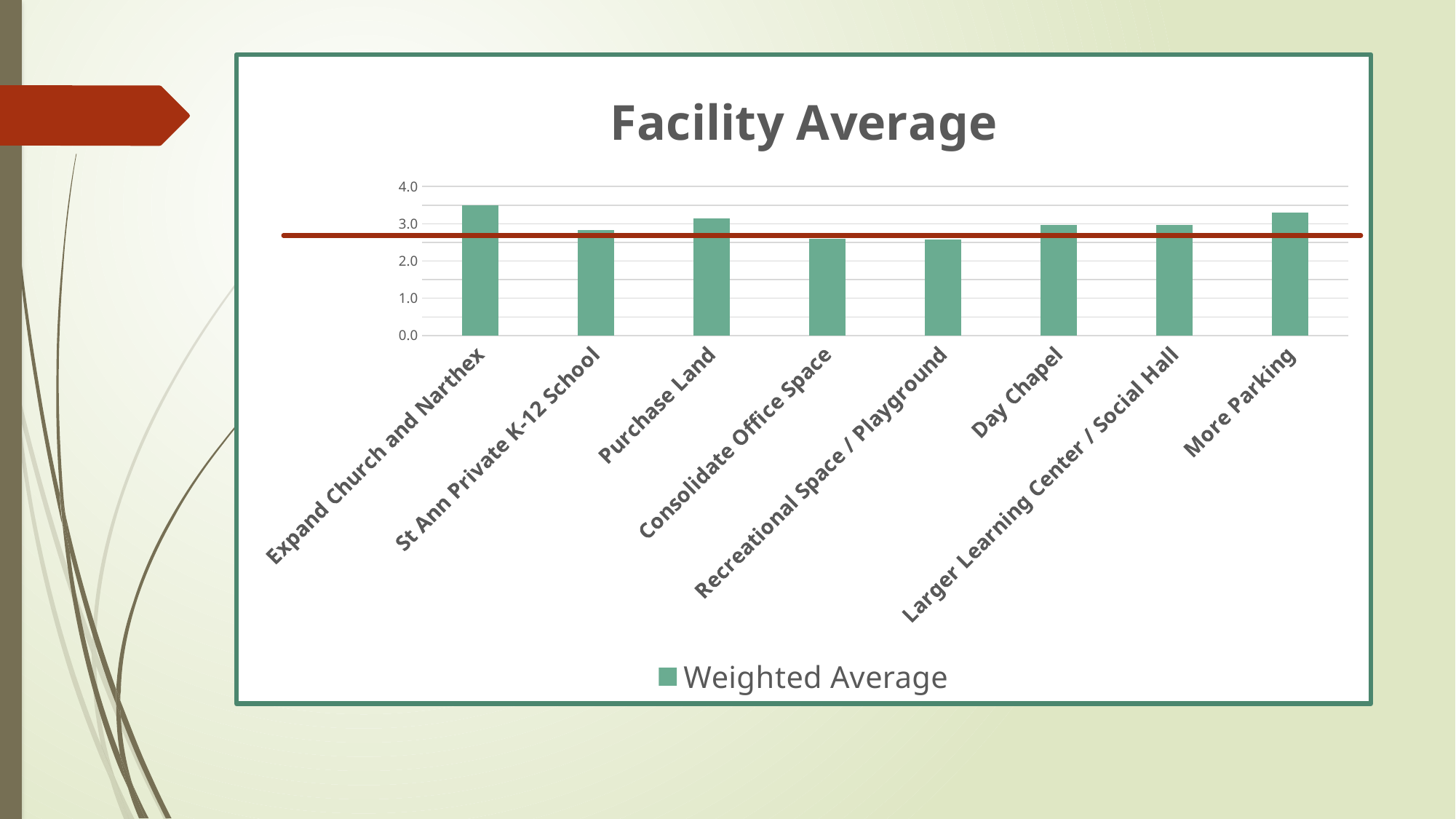
Which has the larger weighted average, Purchase Land or Consolidate Office Space? Purchase Land Is the value for More Parking greater or less than 3.0? greater Is the value for St Ann Private K-12 School greater or less than 3.0? less Is the value for Expand Church and Narthex greater or less than 3.0? greater What series name is shown in the legend? Weighted Average What is the title of the chart? Facility Average Which has the larger weighted average, More Parking or Recreational Space / Playground? More Parking How many categories are plotted on the x axis of the chart? 8 How many series does the legend list? 1 Which category has the highest weighted average? Expand Church and Narthex What kind of chart is shown on the slide? bar chart